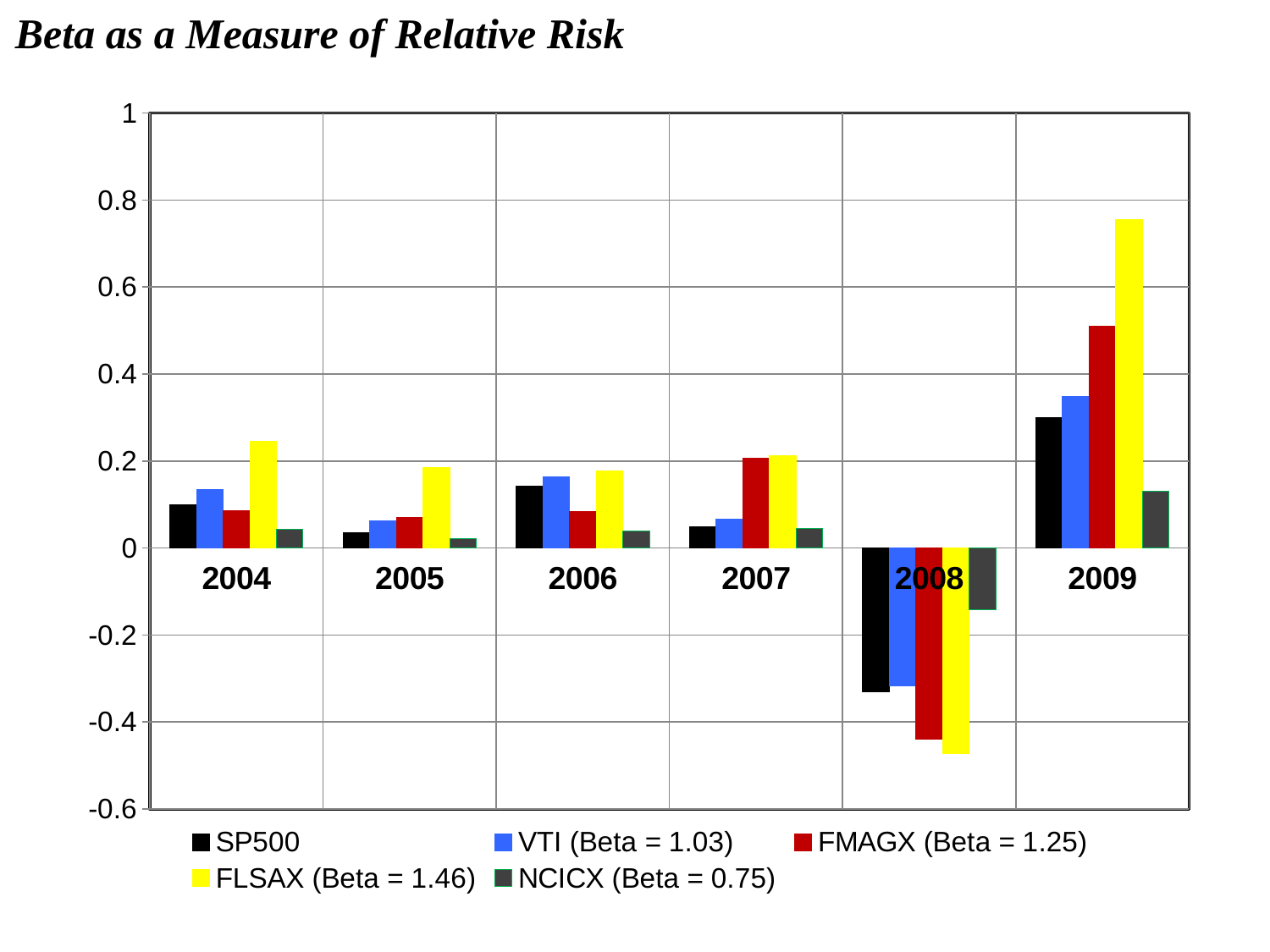
Which series has the highest value in 2009? FLSAX (Beta = 1.46) In 2009, which is larger: the FMAGX value or the VTI value? FMAGX Is the value for NCICX in 2009 greater or less than 0.2? less Is the value for FLSAX in 2009 greater or less than 0.6? greater What beta value does the legend give for FLSAX? 1.46 How many series does the legend list? 5 Is the value for FMAGX in 2008 greater or less than -0.4? less What kind of chart is shown on the slide? bar chart How many years are shown on the x axis? 6 In which year is the SP500 bar the lowest? 2008 In which year is the FLSAX bar the highest? 2009 In 2008, which is larger: the NCICX value or the SP500 value? NCICX